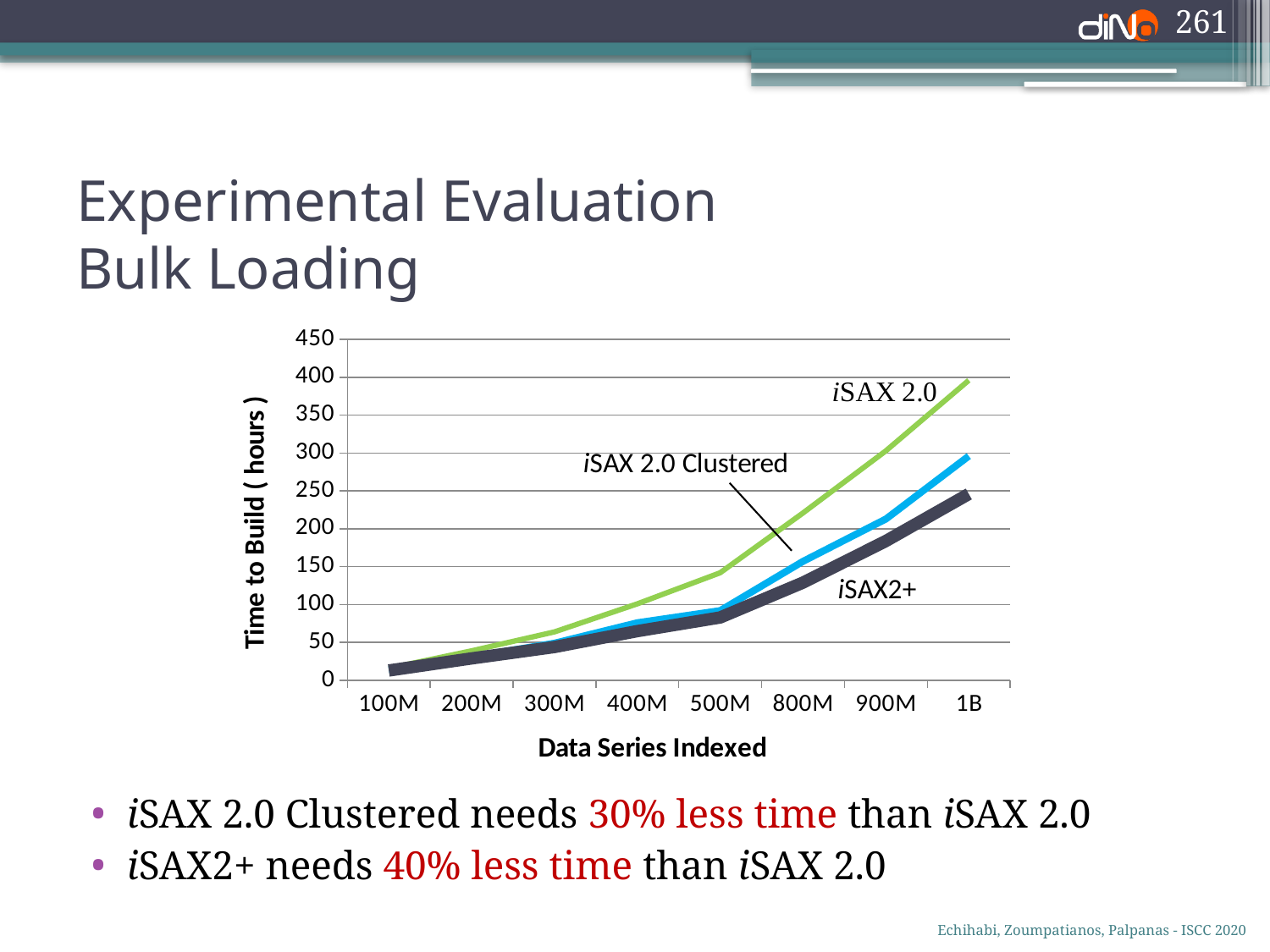
How many data series are plotted in the chart? 3 What is the label of the y axis of the chart? Time to Build ( hours ) Do the time-to-build values rise or fall as the number of data series indexed increases? rise Which series has the lowest time to build at 1B data series? iSAX2+ What kind of chart is shown on the slide? line chart At 900M data series, which has a larger time to build: iSAX 2.0 or iSAX2+? iSAX 2.0 How many points are labelled on the x axis (Data Series Indexed)? 8 Is the time to build for iSAX 2.0 at 1B greater or less than 350 hours? greater Is the time to build for iSAX2+ at 1B greater or less than 300 hours? less Is the time to build for iSAX 2.0 at 500M greater or less than 100 hours? greater Which series has the highest time to build at 1B data series? iSAX 2.0